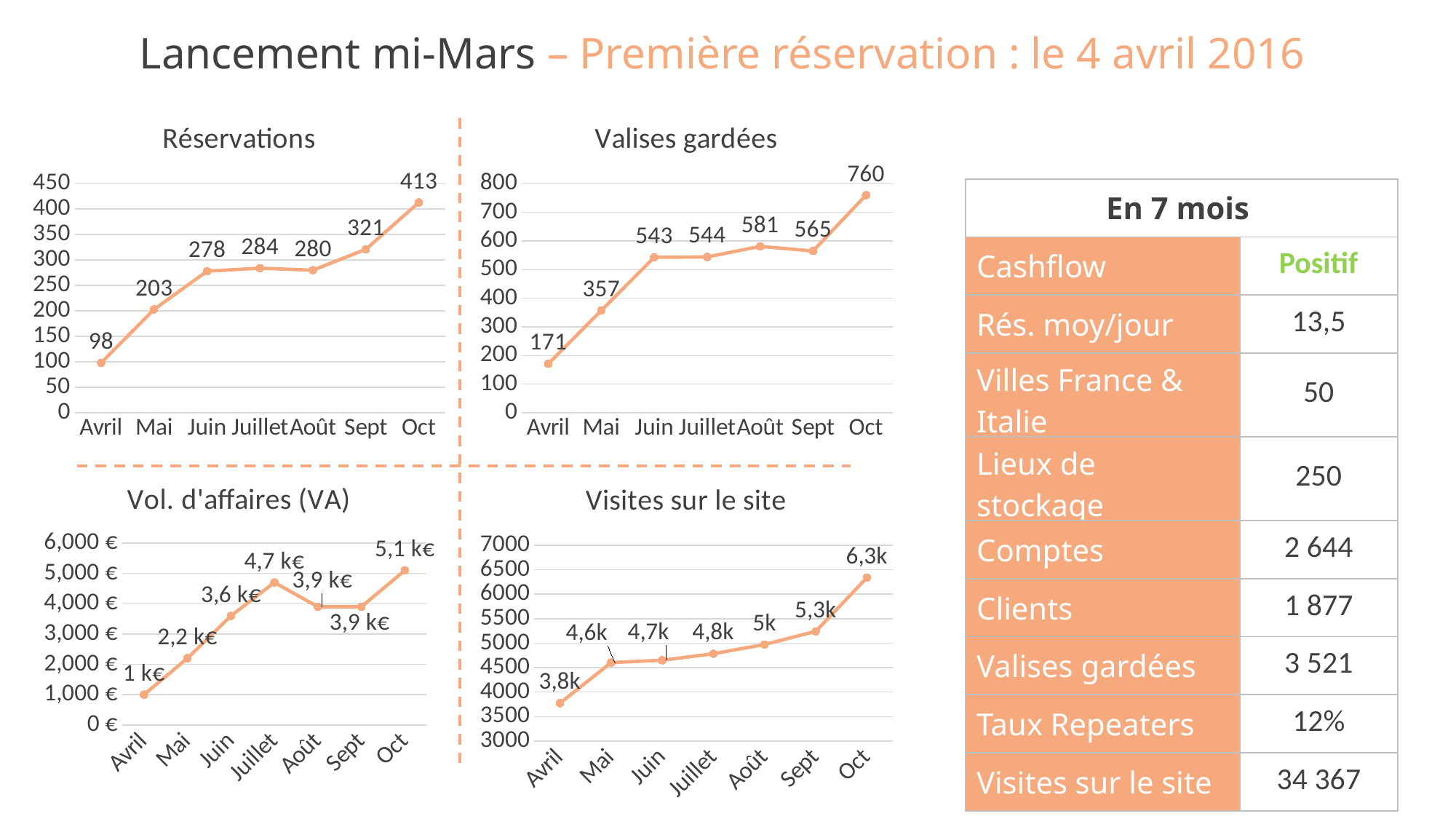
In the Réservations chart, what is the value for Oct? 413 What kind of chart is the Réservations chart? line chart In the Vol. d'affaires (VA) chart, how many months are plotted? 7 In the Réservations chart, what is the difference between the values for Mai and Avril? 105 In the Valises gardées chart, what is the difference between the values for Oct and Sept? 195 In the Vol. d'affaires (VA) chart, what is the value for Juillet? 4,7 k€ In the Valises gardées chart, which month has the highest value? Oct In the Réservations chart, which month has the lowest value? Avril In the Valises gardées chart, what is the value for Août? 581 In the Visites sur le site chart, do the values generally rise or fall from Avril to Oct? rise In the Visites sur le site chart, what is the value for Sept? 5,3k In the Valises gardées chart, is the value for Sept larger or smaller than the value for Août? smaller